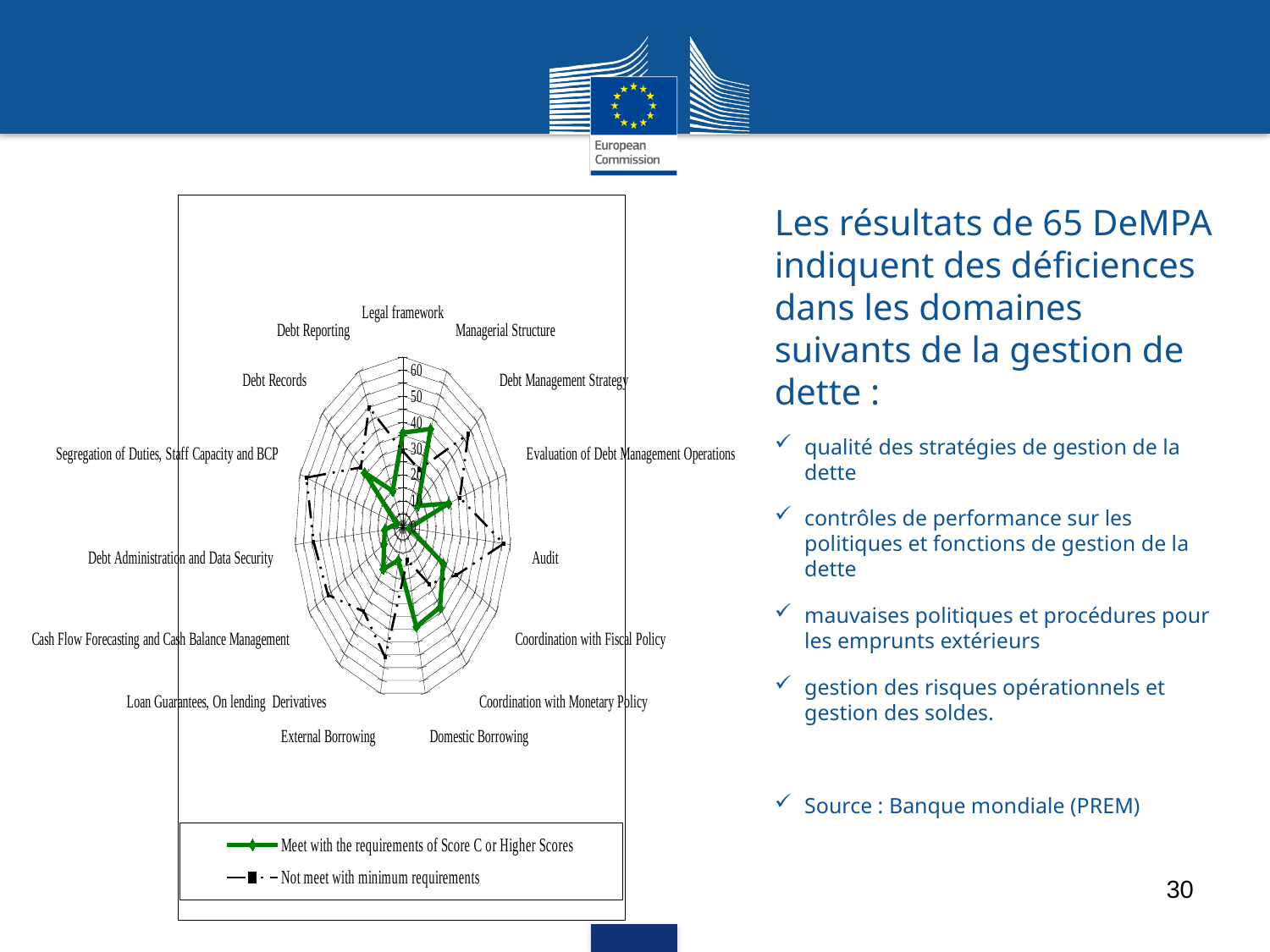
Is the value of the 'Meet with the requirements of Score C or Higher Scores' series for Debt Administration and Data Security greater or less than 30? less For Segregation of Duties, Staff Capacity and BCP, which series has the larger value: 'Meet with the requirements of Score C or Higher Scores' or 'Not meet with minimum requirements'? Not meet with minimum requirements How many categories (axes) does the radar chart have? 15 What is the highest tick value shown on the radar chart's scale? 60 What is the label of the black dashed series in the legend? Not meet with minimum requirements For Coordination with Fiscal Policy, which series has the larger value: 'Meet with the requirements of Score C or Higher Scores' or 'Not meet with minimum requirements'? Not meet with minimum requirements What is the label of the green solid series in the legend? Meet with the requirements of Score C or Higher Scores What kind of chart is shown on the slide? Radar chart Is the value of the 'Meet with the requirements of Score C or Higher Scores' series for Legal framework greater or less than 60? less How many series does the legend of the radar chart list? 2 Is the value of the 'Not meet with minimum requirements' series for Segregation of Duties, Staff Capacity and BCP greater or less than 40? greater